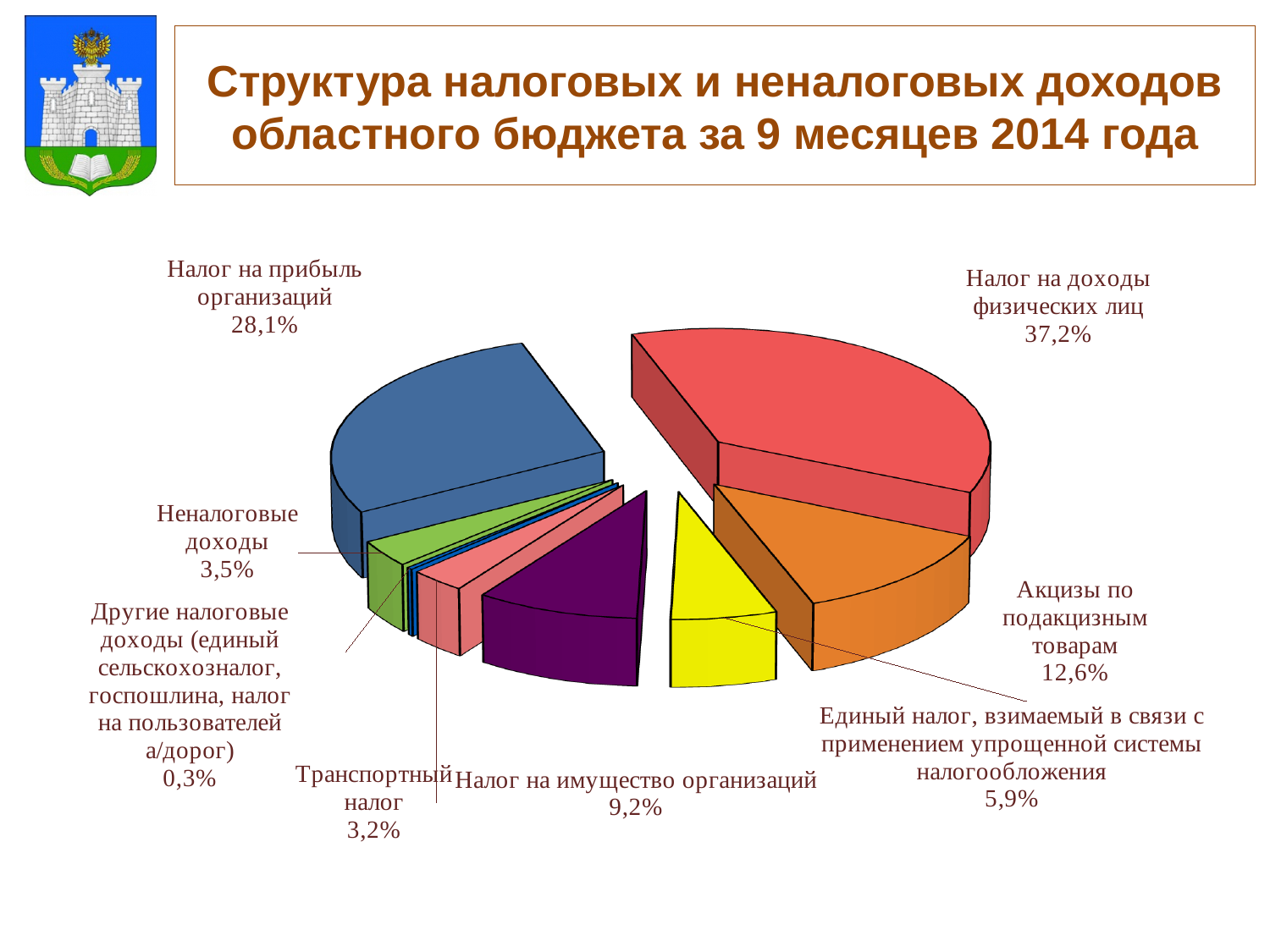
What is the title of the slide containing the chart? Структура налоговых и неналоговых доходов областного бюджета за 9 месяцев 2014 года What percentage is shown for "Акцизы по подакцизным товарам"? 12,6% What share does "Налог на доходы физических лиц" have in the pie chart? 37,2% What type of chart is shown on the slide? Pie chart What is the value for "Транспортный налог"? 3,2% What is the difference between the shares of "Налог на доходы физических лиц" and "Налог на прибыль организаций"? 9,1% How many slices does the pie chart have? 8 Which category has the smallest share in the pie chart? Другие налоговые доходы (единый сельскохозналог, госпошлина, налог на пользователей а/дорог) Which category has the largest share in the pie chart? Налог на доходы физических лиц What is the value shown for "Налог на прибыль организаций"? 28,1% What is the combined share of "Неналоговые доходы" and "Транспортный налог"? 6,7% Which is larger: "Налог на имущество организаций" or "Единый налог, взимаемый в связи с применением упрощенной системы налогообложения"? Налог на имущество организаций